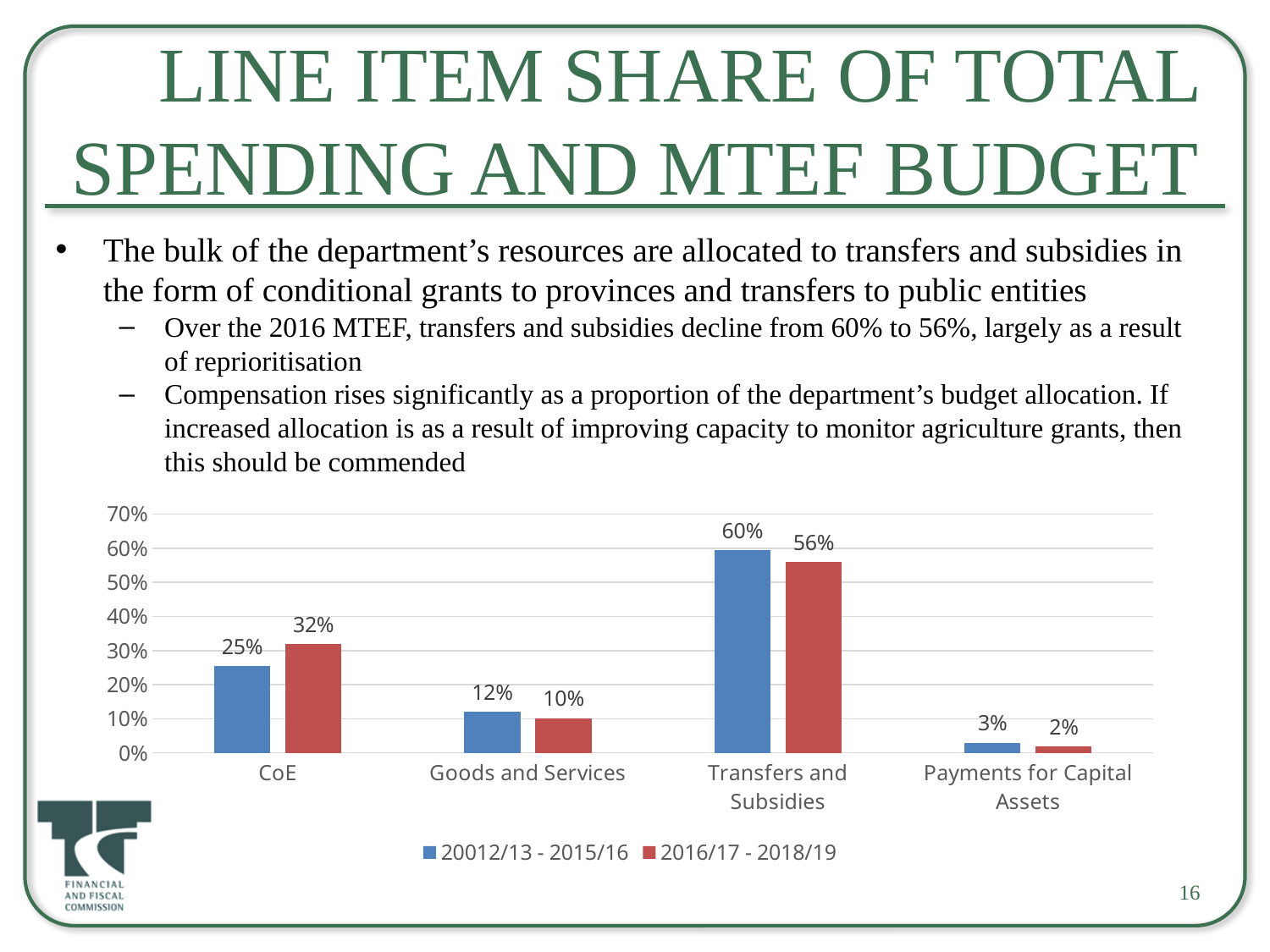
Which category has the lowest value in the 20012/13 - 2015/16 series? Payments for Capital Assets What kind of chart is shown on the slide? Bar chart Which is larger for Goods and Services: the 20012/13 - 2015/16 value or the 2016/17 - 2018/19 value? 20012/13 - 2015/16 What is the value for CoE in the 2016/17 - 2018/19 series? 32% What is the difference between the 20012/13 - 2015/16 and 2016/17 - 2018/19 values for Transfers and Subsidies? 4% What is the value for Goods and Services in the 2016/17 - 2018/19 series? 10% How many categories are shown on the x axis of the chart? 4 What is the value for Transfers and Subsidies in the 20012/13 - 2015/16 series? 60% Which category has the highest value in the 2016/17 - 2018/19 series? Transfers and Subsidies What is the value for Payments for Capital Assets in the 20012/13 - 2015/16 series? 3% How many series does the legend list? 2 What is the difference between the 20012/13 - 2015/16 and 2016/17 - 2018/19 values for CoE? 7%